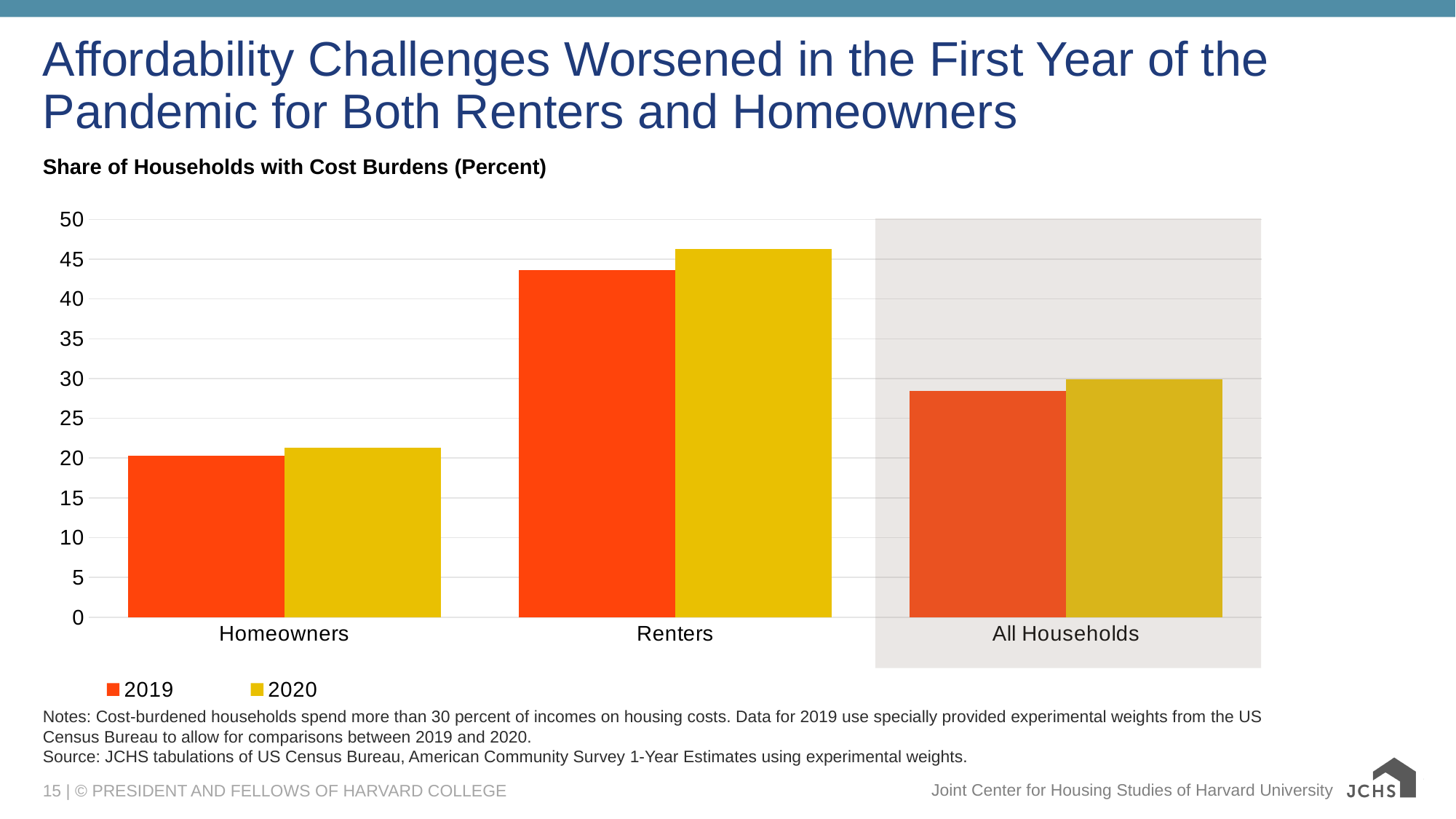
For All Households, which year has the larger value, 2019 or 2020? 2020 Is the 2019 value for Homeowners greater or less than 25? less How many categories are shown on the x axis? 3 How many series does the legend list? 2 Is the 2020 value for Renters greater or less than 45? greater What is the subtitle describing the chart's measure? Share of Households with Cost Burdens (Percent) What kind of chart is shown on the slide? Bar chart Is the 2019 value for Renters greater or less than 45? less Which category has the lowest share of cost-burdened households in 2019? Homeowners For Renters, is the 2020 value larger or the 2019 value larger? 2020 Which category has the highest share of cost-burdened households in 2020? Renters